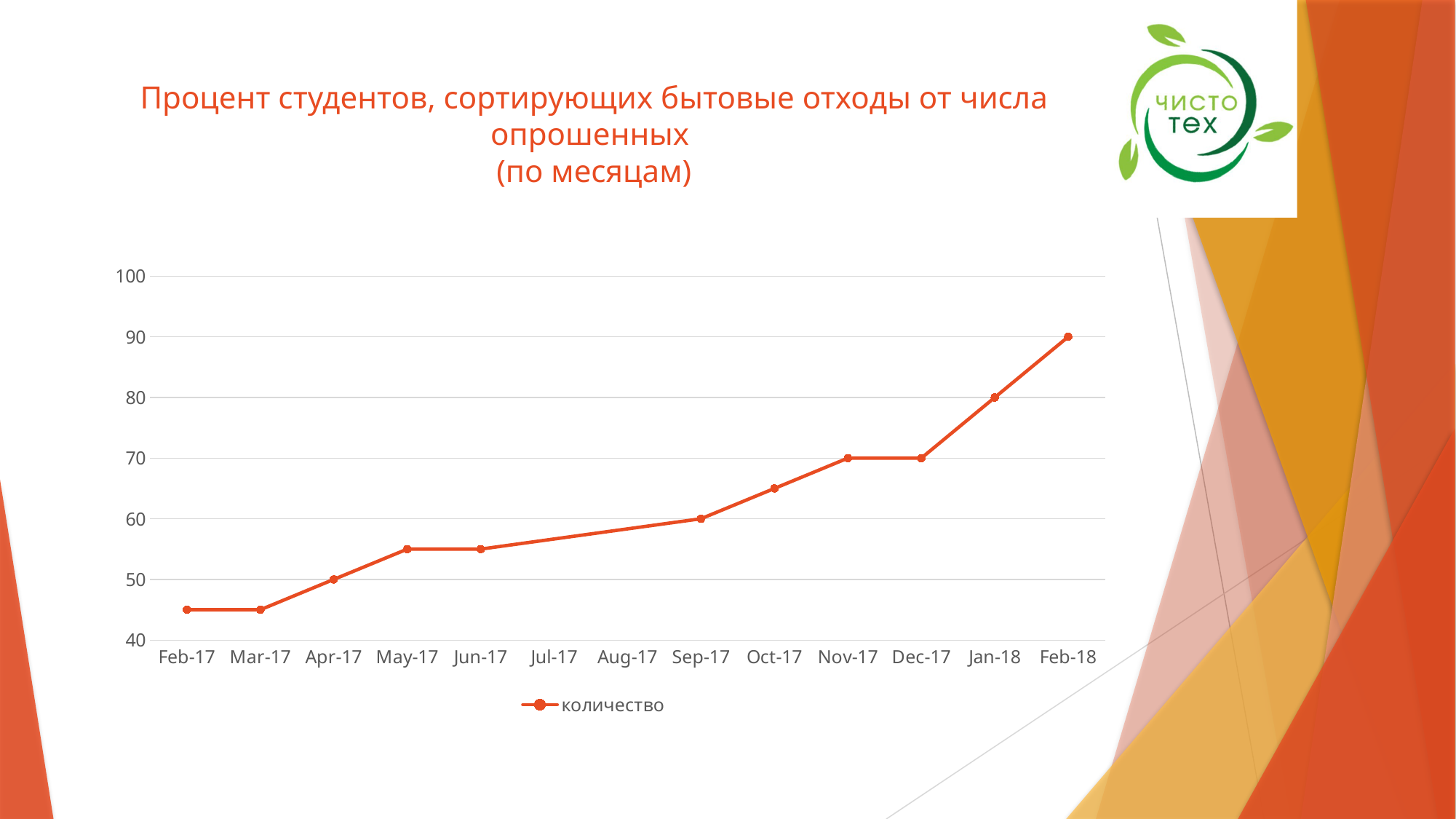
How many series does the legend list? 1 Is the value for Feb-17 greater or less than 50? less What is the value for Nov-17? 70 What is the value for Apr-17? 50 What is the value for Sep-17? 60 What is the difference between the values for Feb-18 and Jan-18? 10 What is the value for Feb-18? 90 What is the value for Jan-18? 80 Which month has the highest value? Feb-18 Do the values generally rise or fall from Feb-17 to Feb-18? rise What kind of chart is shown on the slide? line chart What is the name of the series shown in the legend? количество